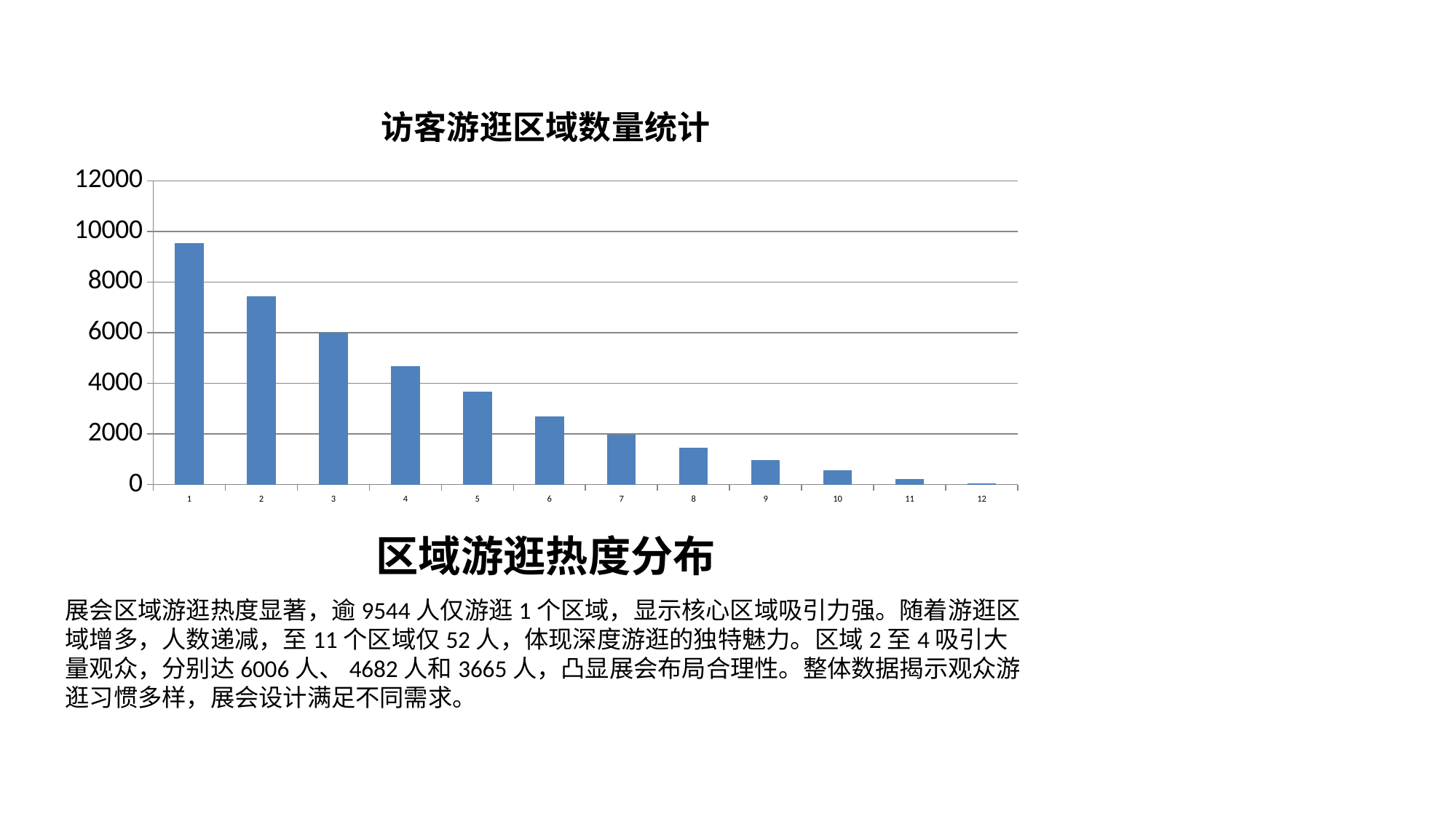
How many categories are plotted on the x axis of the chart? 12 Which is larger, the value for category 3 or the value for category 5? category 3 Is the value for category 4 greater or less than 4000? greater What is the maximum value shown on the vertical axis of the chart? 12000 Do the values rise or fall as you move from category 1 to category 12 along the x axis? fall Is the value for category 1 greater or less than 8000? greater Which category has the highest bar in the chart? 1 Is the value for category 8 greater or less than 2000? less Which category has the lowest bar in the chart? 12 What kind of chart is shown on the slide? bar chart What is the title of the chart? 访客游逛区域数量统计